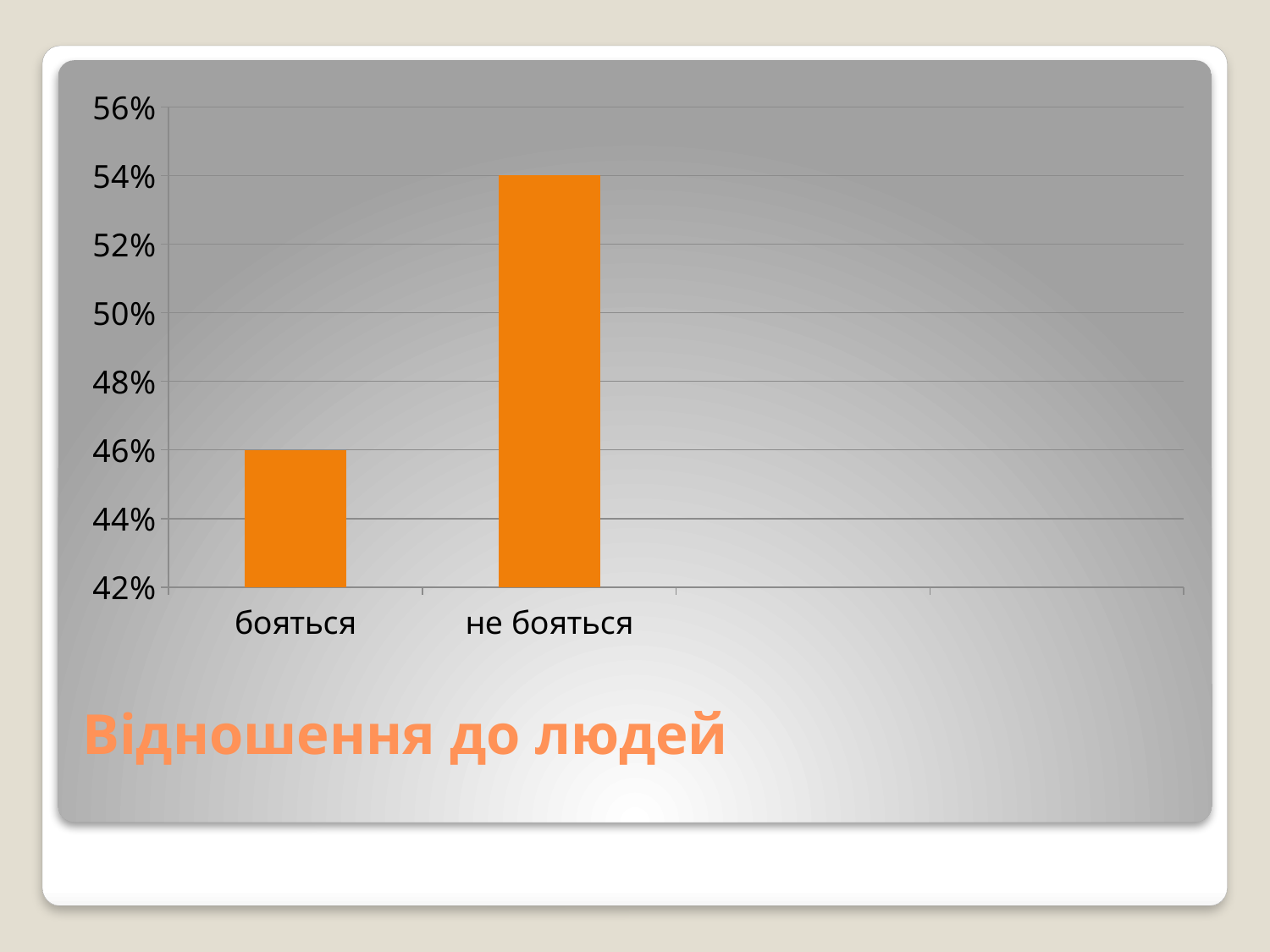
What is the value for "не бояться"? 54% How many categories are shown on the x axis? 2 Which category has the highest value? не бояться Which is larger, the value for "бояться" or the value for "не бояться"? не бояться Which category has the lowest value? бояться Is the value for "бояться" greater or less than 50%? less What is the difference between the values for "не бояться" and "бояться"? 8% Is the value for "не бояться" greater or less than 50%? greater What colour are the bars in the chart? orange What kind of chart is shown on the slide? bar chart What is the title shown below the chart? Відношення до людей What is the value for "бояться"? 46%